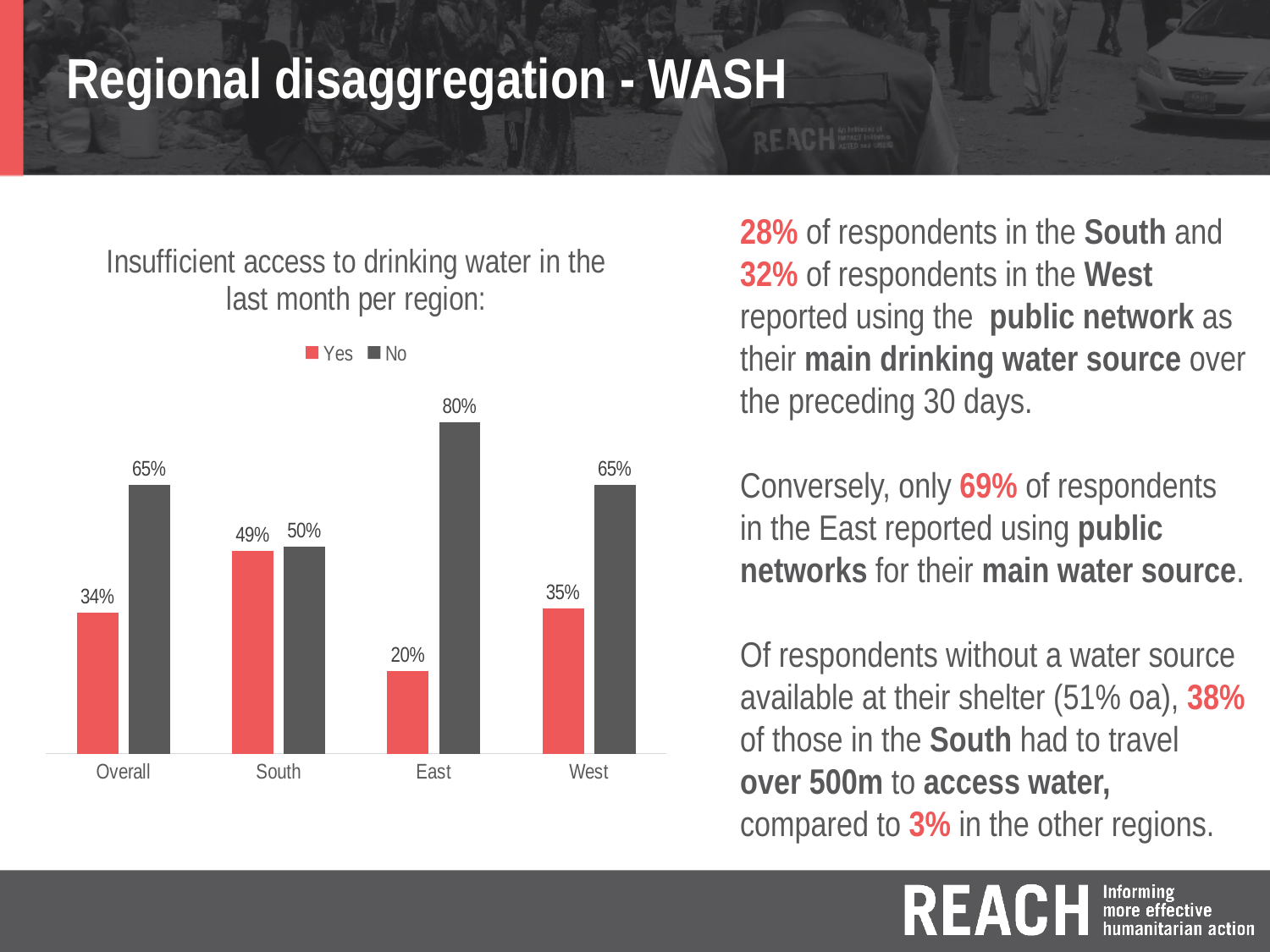
What is the 'Yes' value for the East region? 20% How many regions (categories) are shown on the x axis? 4 What is the title of the chart? Insufficient access to drinking water in the last month per region: What is the 'No' value for the South region? 50% Which region has the highest 'No' value? East What is the difference between the 'No' and 'Yes' values for the East region? 60% How many series does the legend list? 2 Which is larger, the 'Yes' value for South or the 'Yes' value for West? South Which region has the lowest 'Yes' value? East Which colour represents the 'Yes' series in the chart? Red What is the 'Yes' value for Overall? 34% What kind of chart is shown on the slide? Bar chart